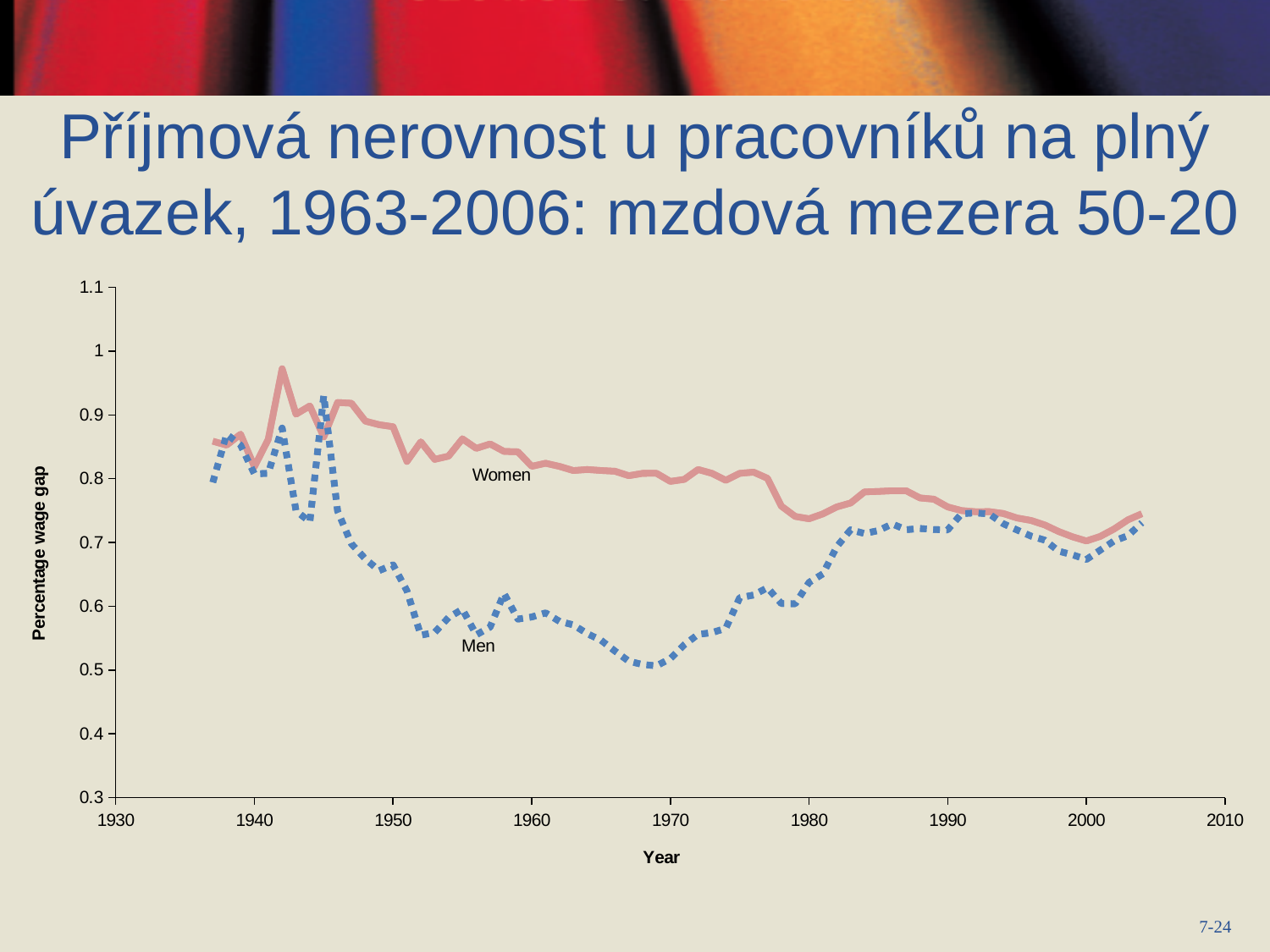
What is the label of the vertical axis? Percentage wage gap How many series are plotted on the chart? 2 Is the value for Women around 1990 greater or less than 0.7? greater Is the value for Men around 1950 greater or less than 0.7? less Does the Men series rise or fall between 1970 and 1985? rise Is the value for Women around 1960 greater or less than 0.8? greater What kind of chart is shown on the slide? line chart What are the names of the two series plotted on the chart? Women and Men Around 1970, which series has the higher value, Women or Men? Women Does the Women series generally rise or fall between 1950 and 2000? fall